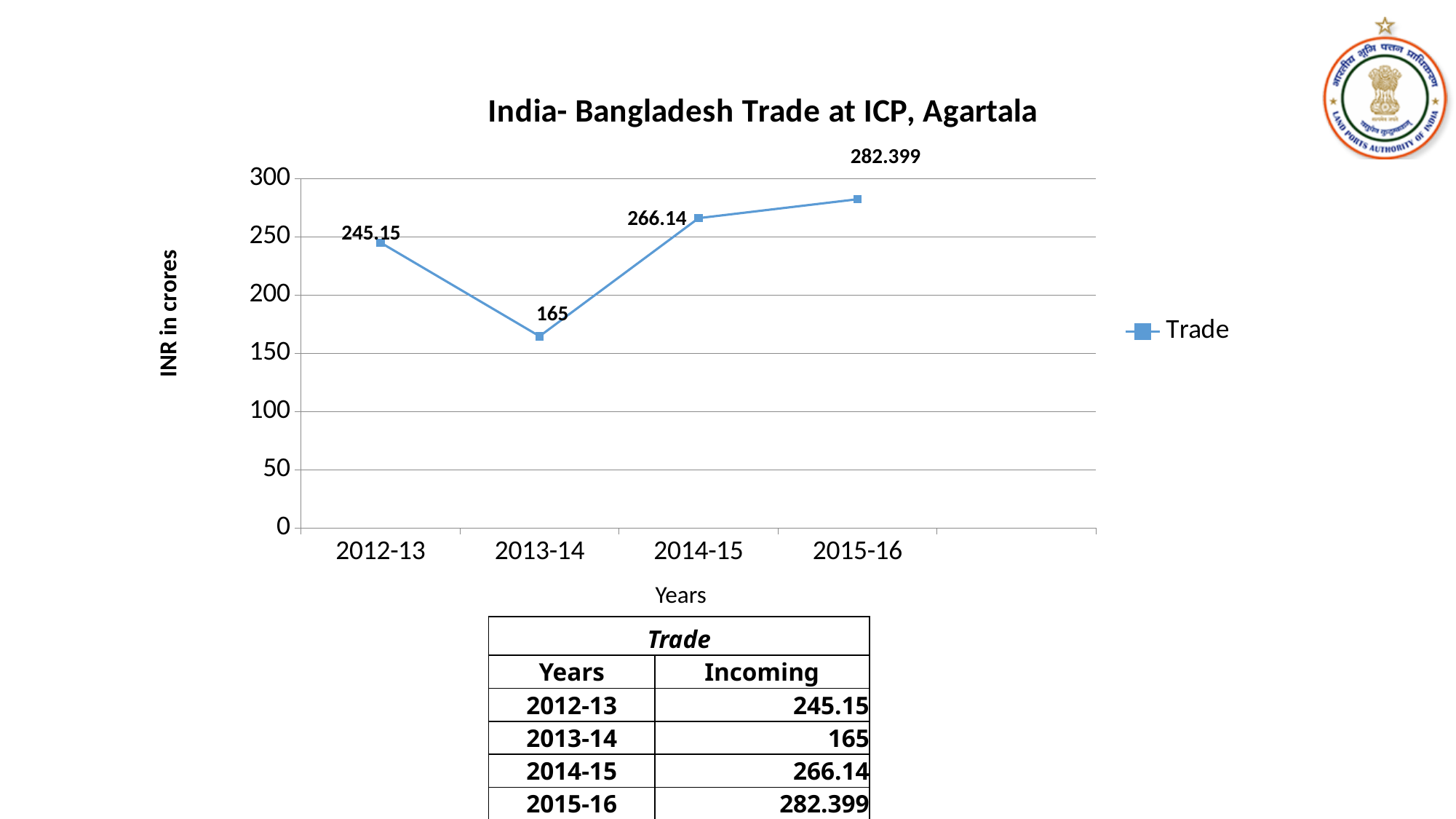
What is the Trade value for 2013-14? 165 Is the Trade value for 2013-14 greater or less than 200? less What kind of chart is shown? line chart Which year has the highest Trade value? 2015-16 What is the Trade value for 2012-13? 245.15 Which year has the lowest Trade value? 2013-14 What is the difference between the Trade values for 2014-15 and 2013-14? 101.14 How many years are plotted on the chart? 4 What is the Trade value for 2015-16? 282.399 What is the title of the chart? India- Bangladesh Trade at ICP, Agartala How many series does the legend list? 1 Which is larger, the Trade value for 2012-13 or for 2014-15? 2014-15